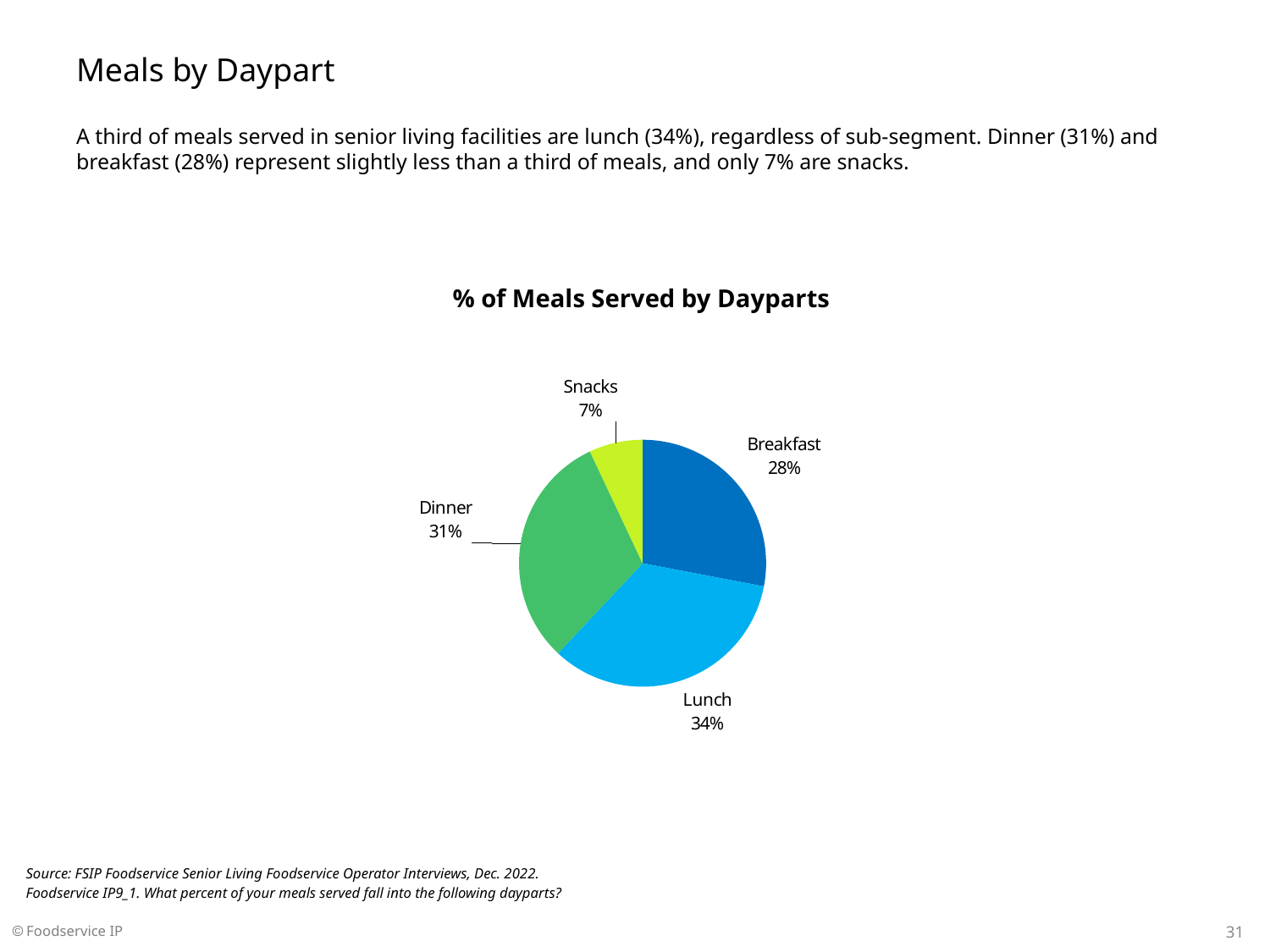
Which daypart has the smallest share of meals served? Snacks Which daypart has the largest share of meals served? Lunch What colour is the Lunch slice in the pie chart? Light blue What percentage of meals served are breakfast? 28% What type of chart is shown on the slide? Pie chart Which has a larger share of meals served, Dinner or Breakfast? Dinner What percentage of meals served are dinner? 31% What percentage of meals served are lunch? 34% What is the difference in percentage points between the Lunch and Breakfast shares? 6 What is the title of the chart? % of Meals Served by Dayparts How many dayparts (slices) are shown in the pie chart? 4 What percentage of meals served are snacks? 7%